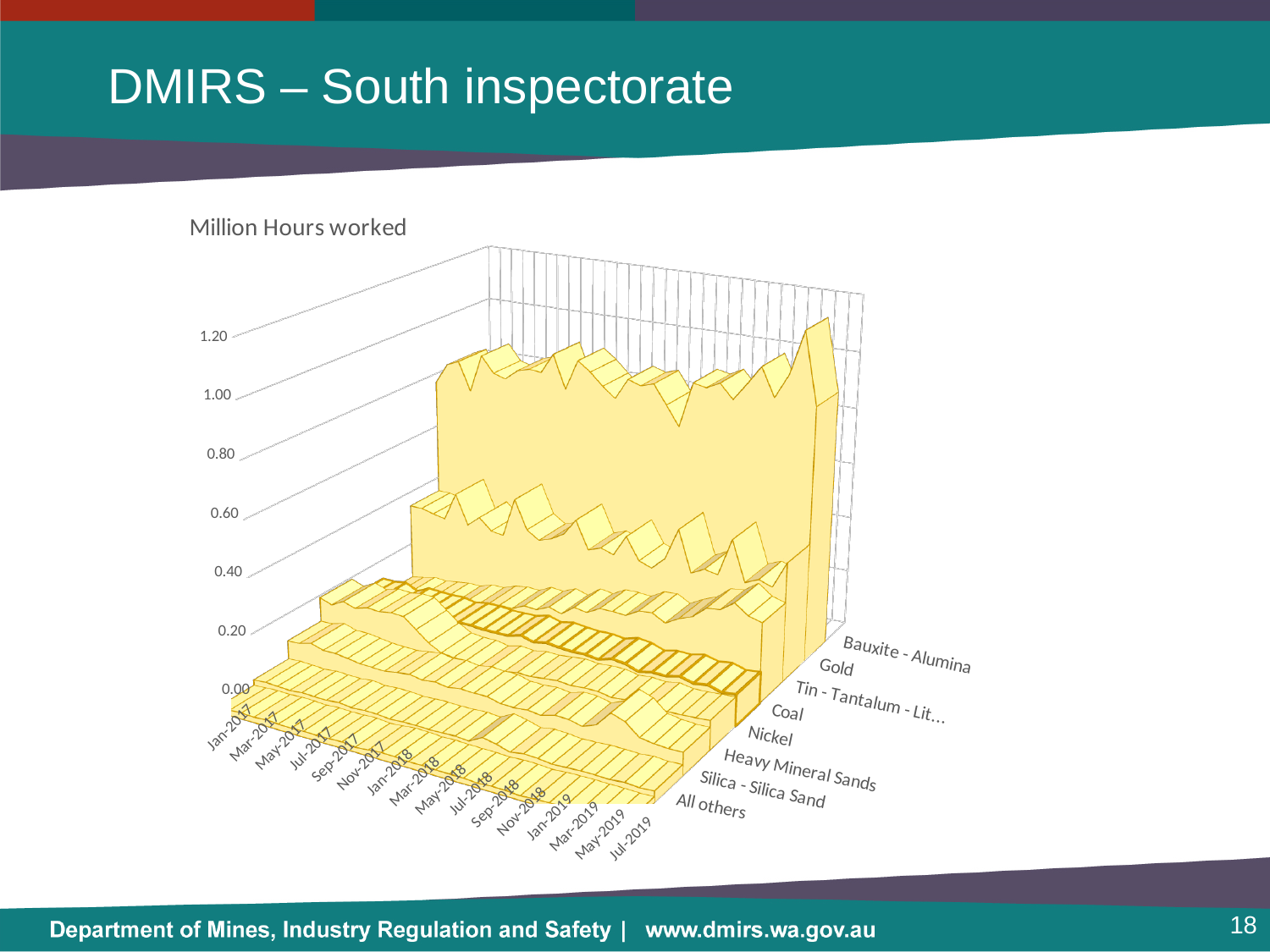
What kind of chart is shown on the slide? 3D area chart Are the values for Bauxite - Alumina greater or less than 0.40? greater How many date labels are shown along the x axis? 16 Which series has the highest values in the chart? Bauxite - Alumina Which series has larger values, Bauxite - Alumina or All others? Bauxite - Alumina How many series (commodity categories) are labelled on the chart's depth axis? 8 What is the title of the chart? Million Hours worked Which series has larger values, Gold or Nickel? Gold Are the values for All others greater or less than 0.40? less What is the highest value shown on the vertical axis? 1.20 Which series has larger values, Gold or Silica - Silica Sand? Gold